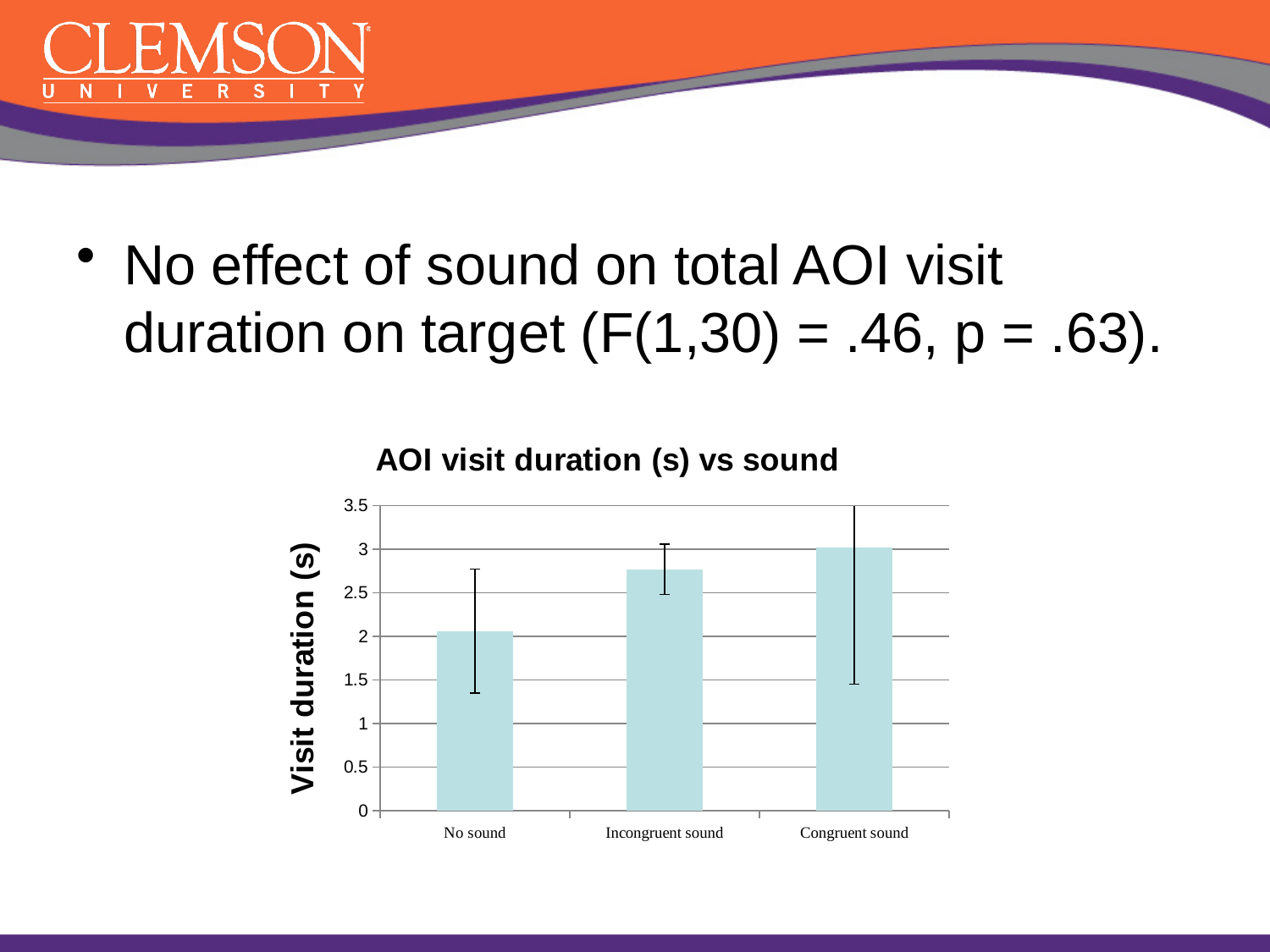
Is the visit duration for No sound greater or less than 2.5? less Which sound condition has the highest visit duration? Congruent sound Which has a larger visit duration, No sound or Incongruent sound? Incongruent sound Is the visit duration for Incongruent sound greater or less than 3? less Is the visit duration for Incongruent sound greater or less than 2.5? greater What is the title of the chart? AOI visit duration (s) vs sound Which sound condition has the lowest visit duration? No sound What kind of chart is shown on the slide? bar chart How many sound conditions (categories) are plotted in the chart? 3 What is the label on the vertical axis of the chart? Visit duration (s) Do the visit duration values rise or fall from No sound to Congruent sound along the x axis? rise